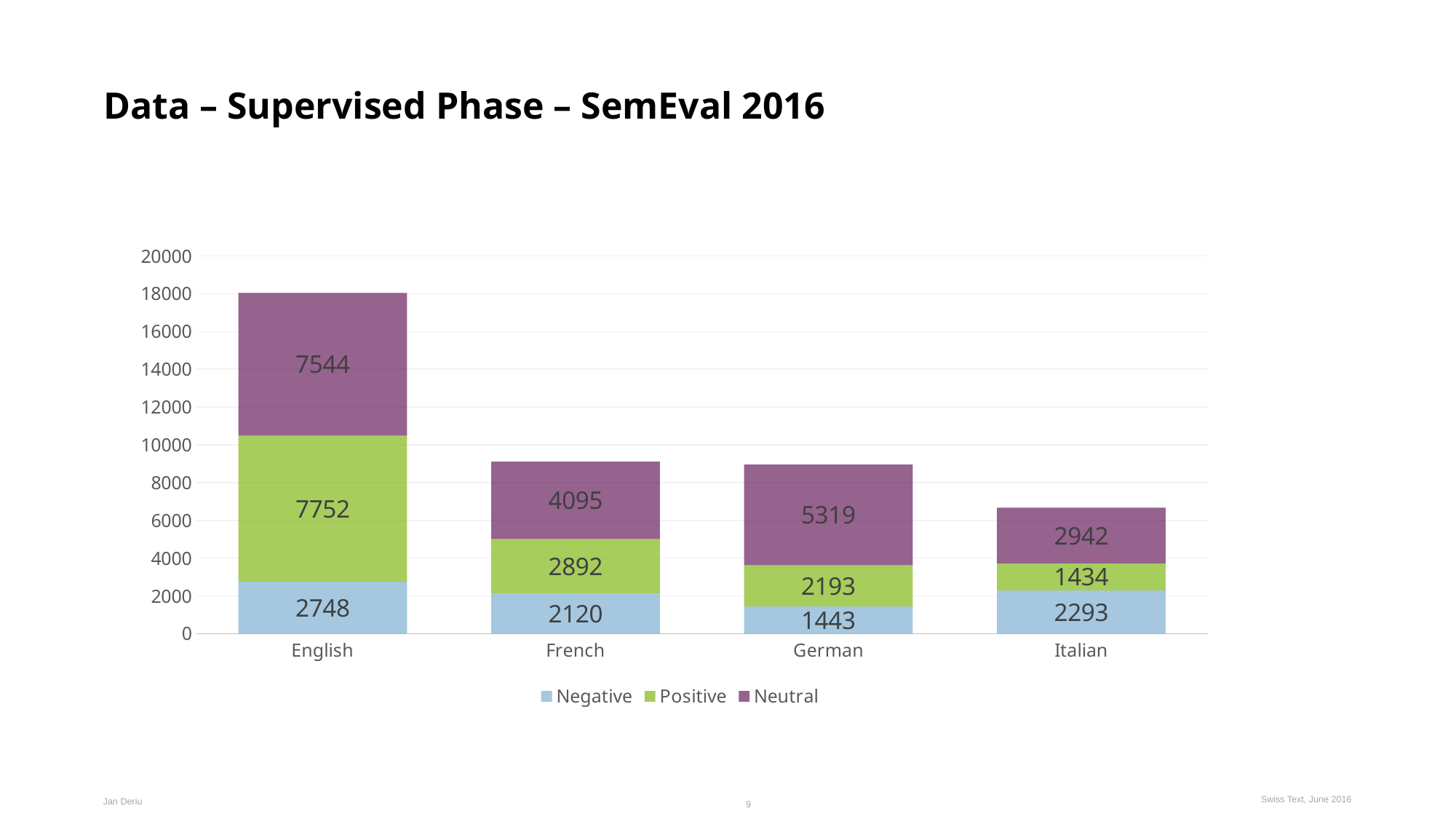
What is the total of the stacked bar for Italian? 6669 What is the Negative value for Italian? 2293 How many series does the legend list? 3 What is the Neutral value for English? 7544 What is the Positive value for German? 2193 How many languages (categories) are shown on the x axis? 4 Which series is shown in green in the legend? Positive Which language has the lowest Negative value? German What kind of chart is shown on the slide? Stacked bar chart What is the difference between the Neutral values for German and French? 1224 Which language has the highest Positive value? English Which is larger, the Positive value for French or the Positive value for Italian? French